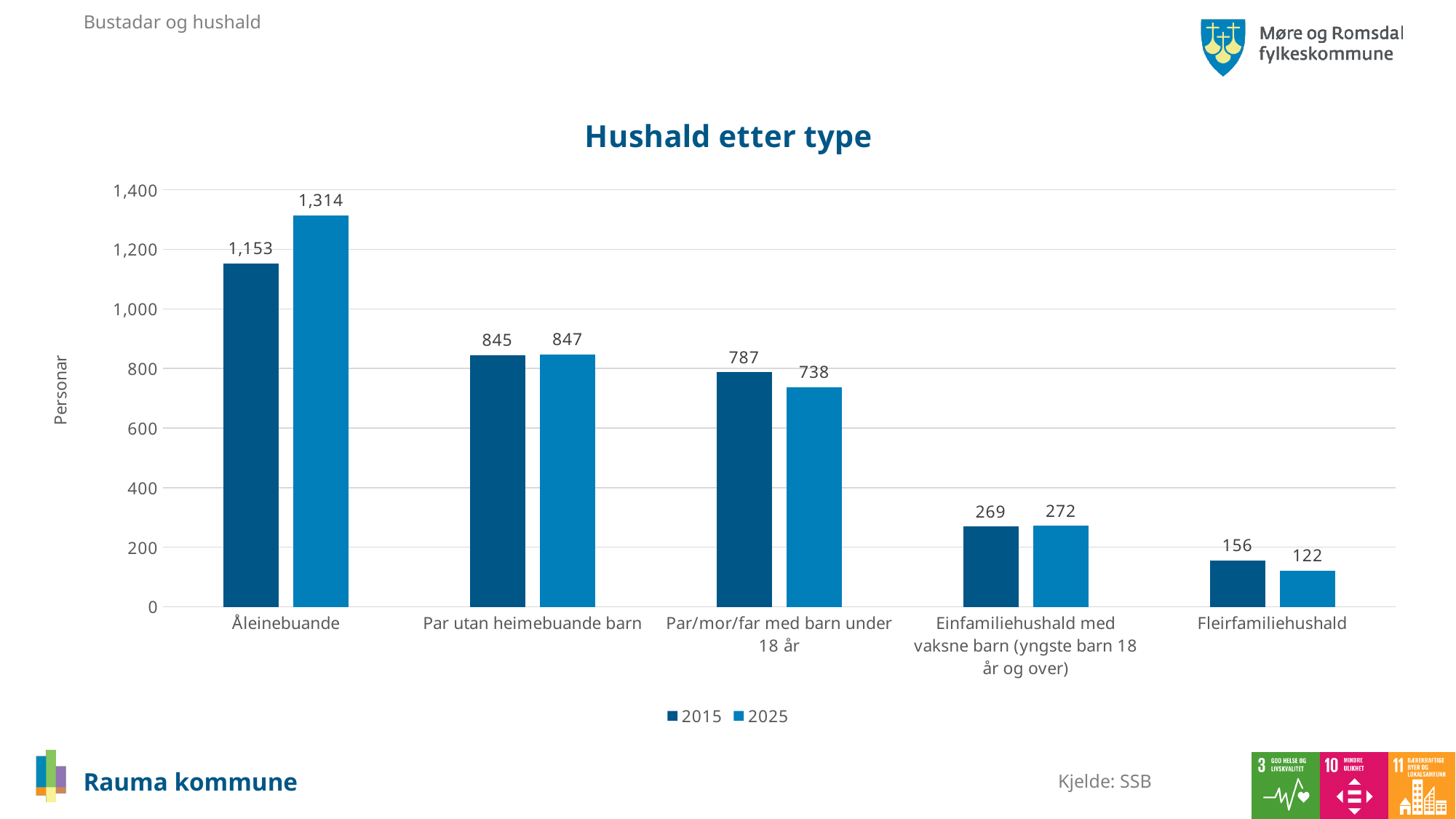
What is the value for Åleinebuande in 2025? 1,314 How many household categories are shown on the x axis? 5 What is the value for Par/mor/far med barn under 18 år in 2015? 787 What is the difference between the 2015 and 2025 values for Par/mor/far med barn under 18 år? 49 Which is larger for Fleirfamiliehushald, the 2015 value or the 2025 value? 2015 What kind of chart is shown on the slide? Bar chart Which category has the lowest value in 2025? Fleirfamiliehushald What is the value for Fleirfamiliehushald in 2025? 122 Is the 2015 value for Par utan heimebuande barn greater or less than 800? greater Which category has the highest value in 2015? Åleinebuande What is the difference between the 2025 and 2015 values for Åleinebuande? 161 How many series does the legend list? 2